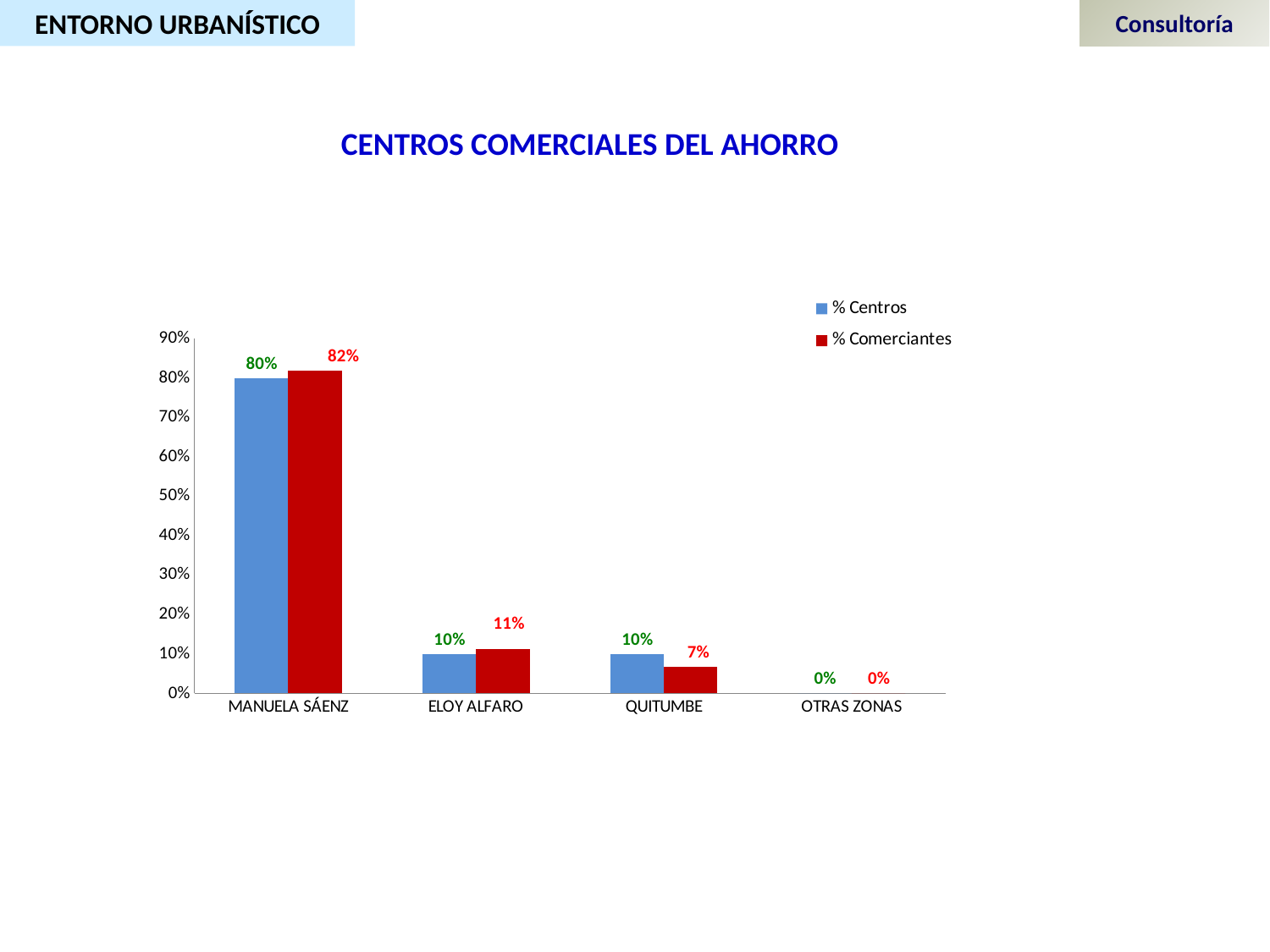
What is the % Comerciantes value for QUITUMBE? 7% How many series does the legend list? 2 How many categories are shown on the x axis? 4 What is the title of the chart? CENTROS COMERCIALES DEL AHORRO What is the % Centros value for MANUELA SÁENZ? 80% What is the % Comerciantes value for ELOY ALFARO? 11% What kind of chart is shown on the slide? Bar chart What is the % Centros value for OTRAS ZONAS? 0% For QUITUMBE, which is larger: % Centros or % Comerciantes? % Centros What is the difference between the % Comerciantes and % Centros values for MANUELA SÁENZ? 2% Which category has the lowest % Centros value? OTRAS ZONAS Which category has the highest % Comerciantes value? MANUELA SÁENZ